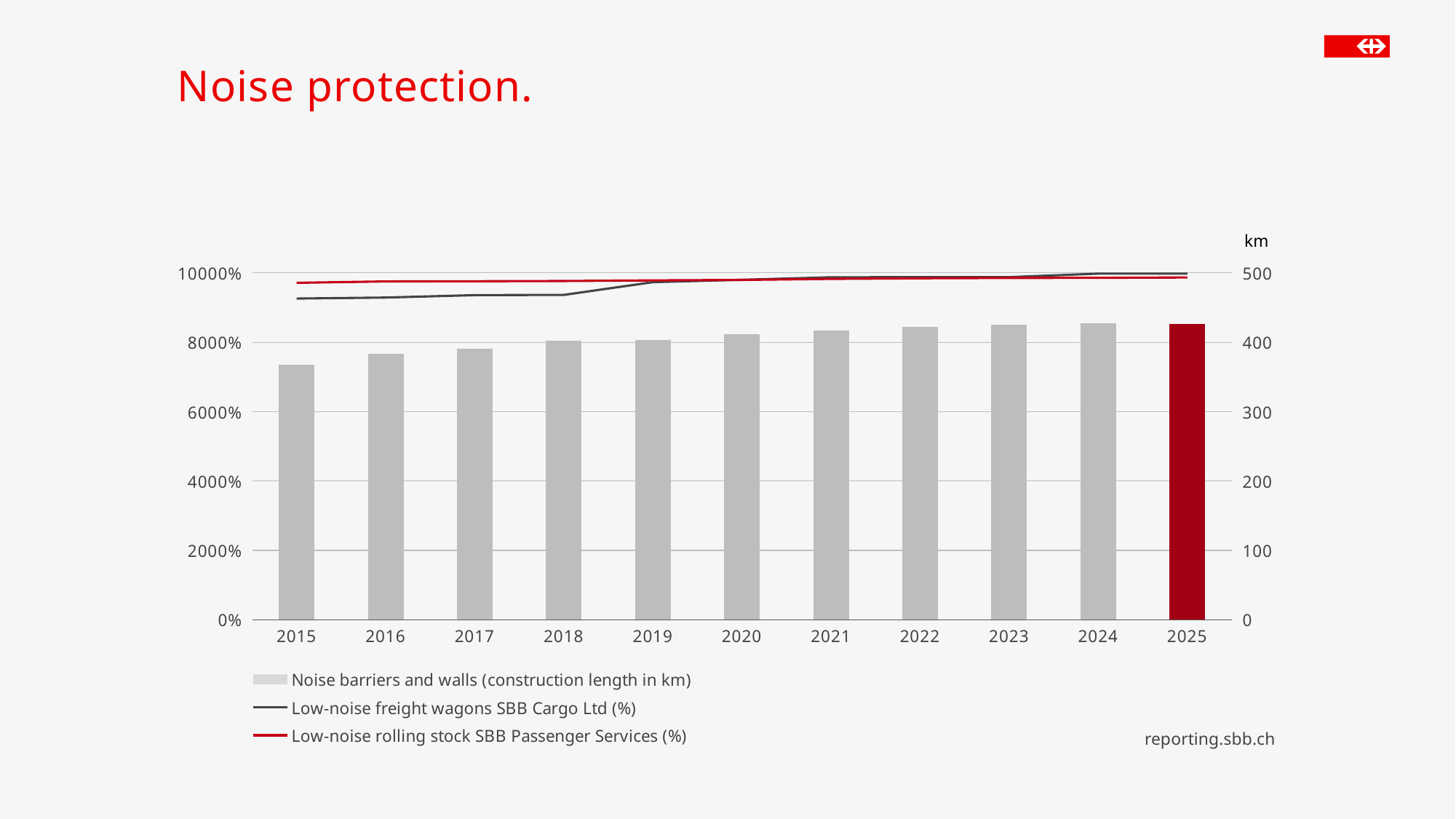
What unit is labelled on the right-hand axis? km Which year has the lowest value for Noise barriers and walls (construction length in km)? 2015 Which is larger, the Noise barriers and walls value for 2015 or for 2021? 2021 Is the value for Low-noise freight wagons SBB Cargo Ltd (%) in 2015 greater or less than 10000%? less Is the value for Noise barriers and walls in 2025 greater or less than 400 km? greater How many years are shown on the x axis? 11 What is the title of the chart? Noise protection. Is the value for Noise barriers and walls in 2015 greater or less than 400 km? less Does the Noise barriers and walls series rise or fall from 2015 to 2025? rise What kind of chart is shown on the slide? A combined bar and line chart How many series does the legend list? 3